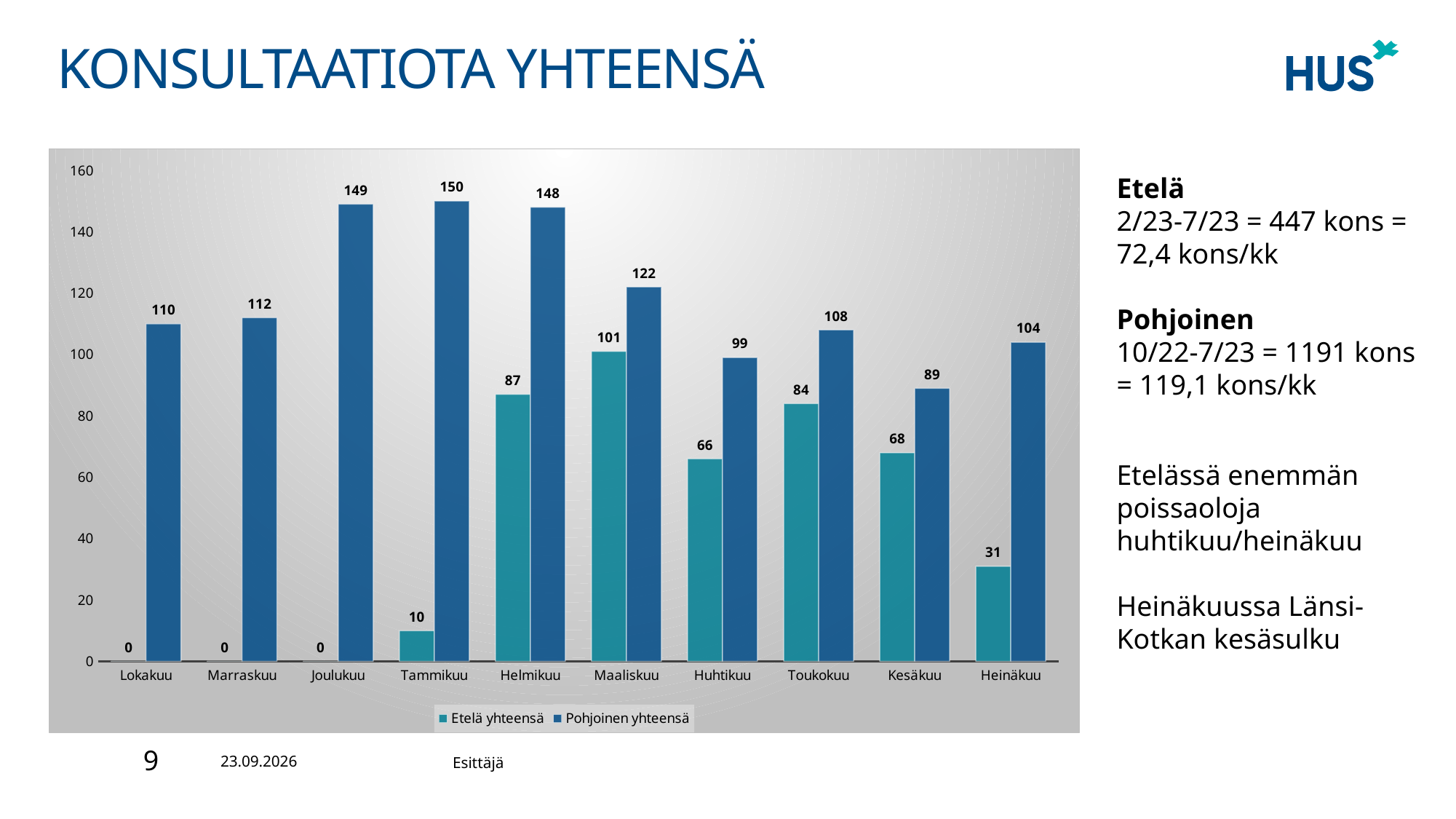
What type of chart is shown on the slide? bar chart Is the value of Pohjoinen yhteensä for Joulukuu greater or less than 140? greater What is the difference between Pohjoinen yhteensä and Etelä yhteensä in Huhtikuu? 33 What is the value of Etelä yhteensä for Maaliskuu? 101 Which is larger in Toukokuu, Etelä yhteensä or Pohjoinen yhteensä? Pohjoinen yhteensä What is the value of Pohjoinen yhteensä for Tammikuu? 150 Which month has the lowest value for Pohjoinen yhteensä? Kesäkuu What is the value of Etelä yhteensä for Heinäkuu? 31 Which month has the highest value for Pohjoinen yhteensä? Tammikuu Which series is shown in teal in the legend? Etelä yhteensä How many months are shown on the x axis? 10 How many series does the legend list? 2